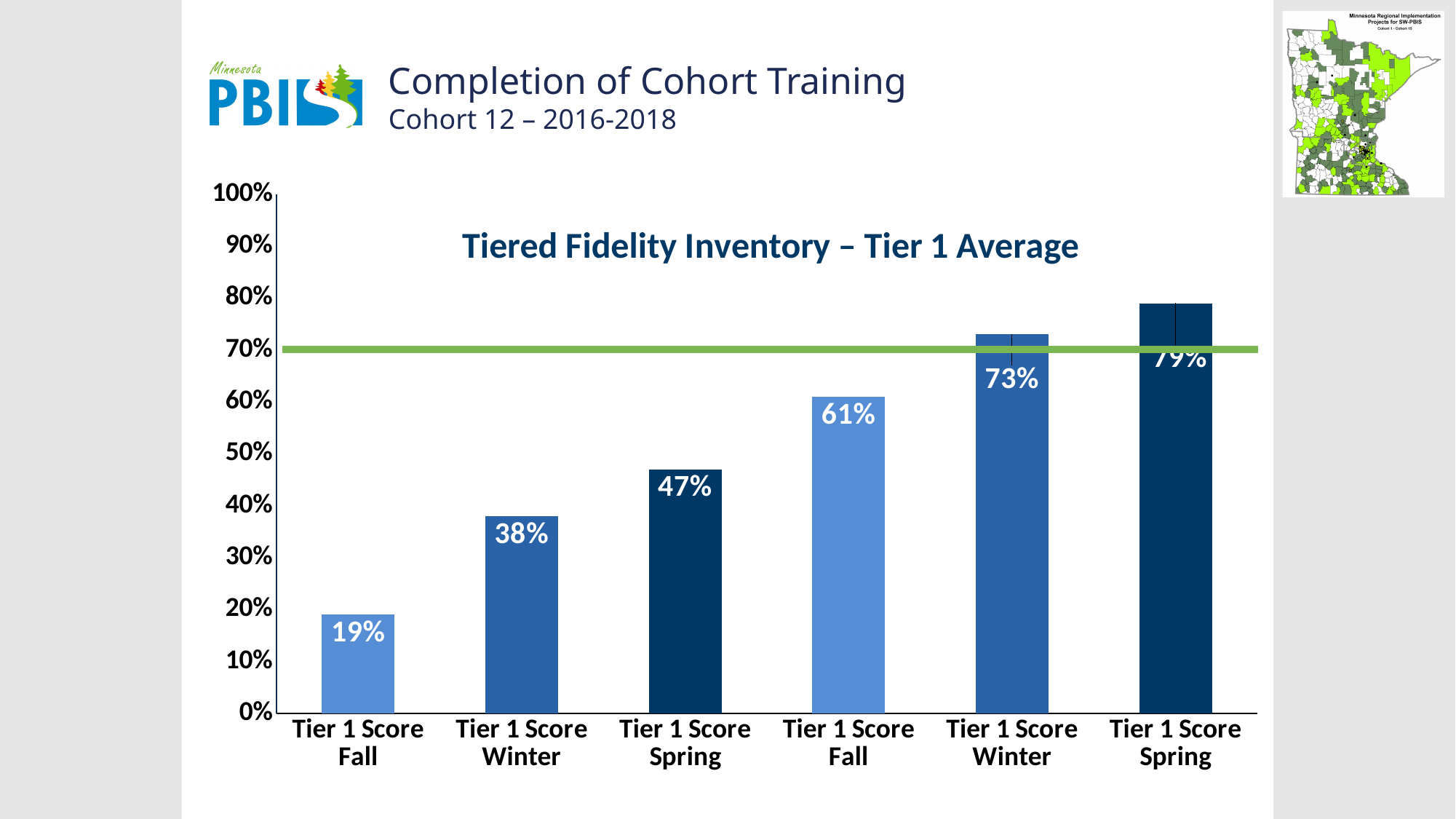
What is the value of the first Tier 1 Score Fall bar (leftmost)? 19% What kind of chart is shown on the slide? Bar chart What is the value of the second Tier 1 Score Winter bar (fifth from the left)? 73% How many bars are plotted in the chart? 6 What is the difference between the second Tier 1 Score Fall bar (fourth from the left) and the first Tier 1 Score Winter bar (second from the left)? 23% Do the bar values rise or fall from left to right? Rise What is the value of the first Tier 1 Score Spring bar (third from the left)? 47% What is the difference between the rightmost Tier 1 Score Spring bar and the leftmost Tier 1 Score Fall bar? 60% What is the title of the chart? Tiered Fidelity Inventory – Tier 1 Average Which bar has the highest value? Tier 1 Score Spring (rightmost bar) Which bar has the lowest value? Tier 1 Score Fall (leftmost bar) Which is larger, the first Tier 1 Score Spring bar (third from the left) or the second Tier 1 Score Fall bar (fourth from the left)? Tier 1 Score Fall (fourth from the left)